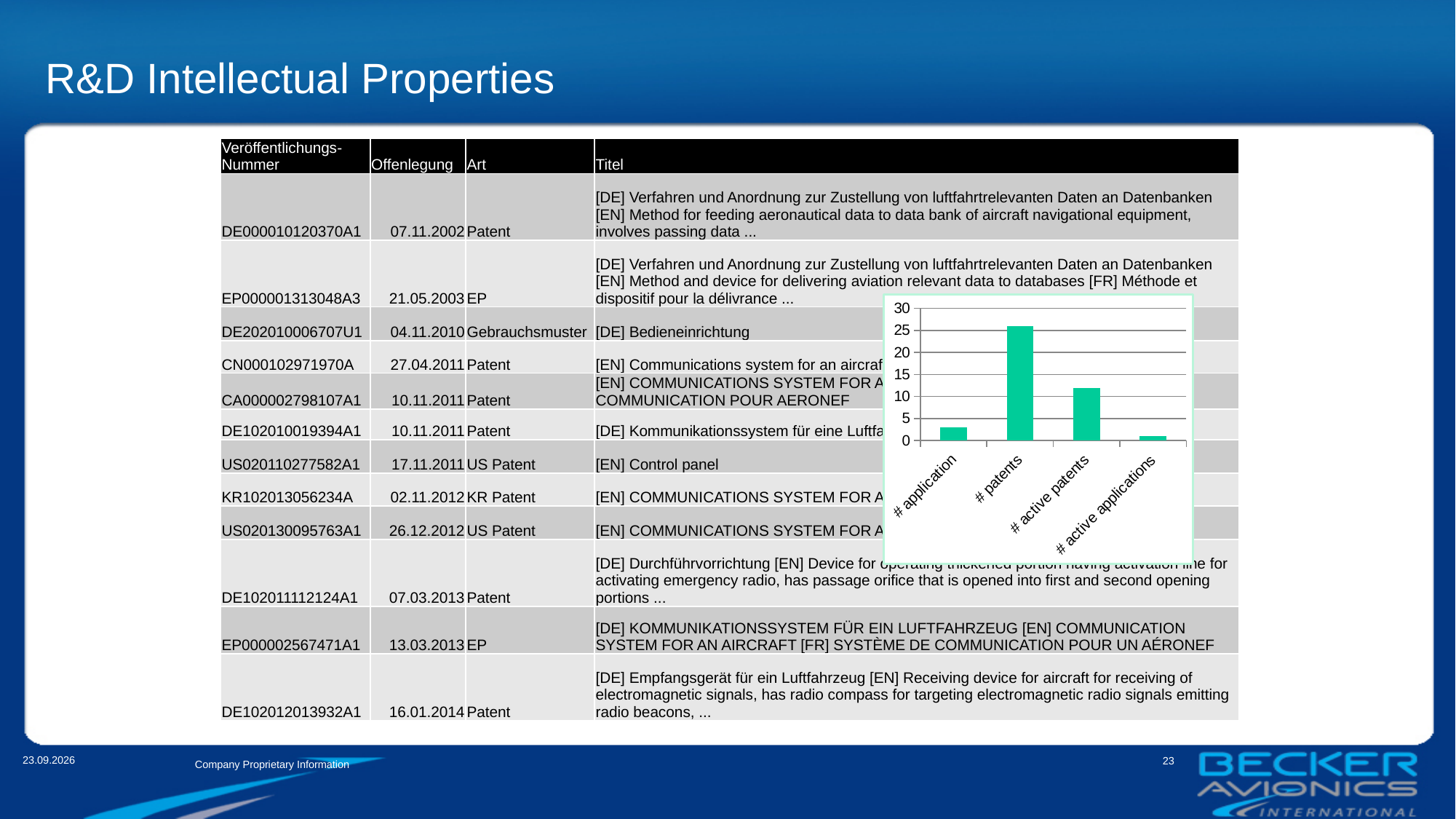
Which is larger, the value for # patents or the value for # active patents? # patents Is the value for # active applications greater or less than 5? less Which category has the highest bar in the chart? # patents Which category has the lowest bar in the chart? # active applications How many categories are shown on the x axis of the chart? 4 Which is larger, the value for # application or the value for # active applications? # application What colour are the bars in the chart? green Is the value for # application greater or less than 5? less Is the value for # active patents greater or less than 10? greater What kind of chart is shown on the slide? bar chart What is the highest value shown on the chart's vertical axis? 30